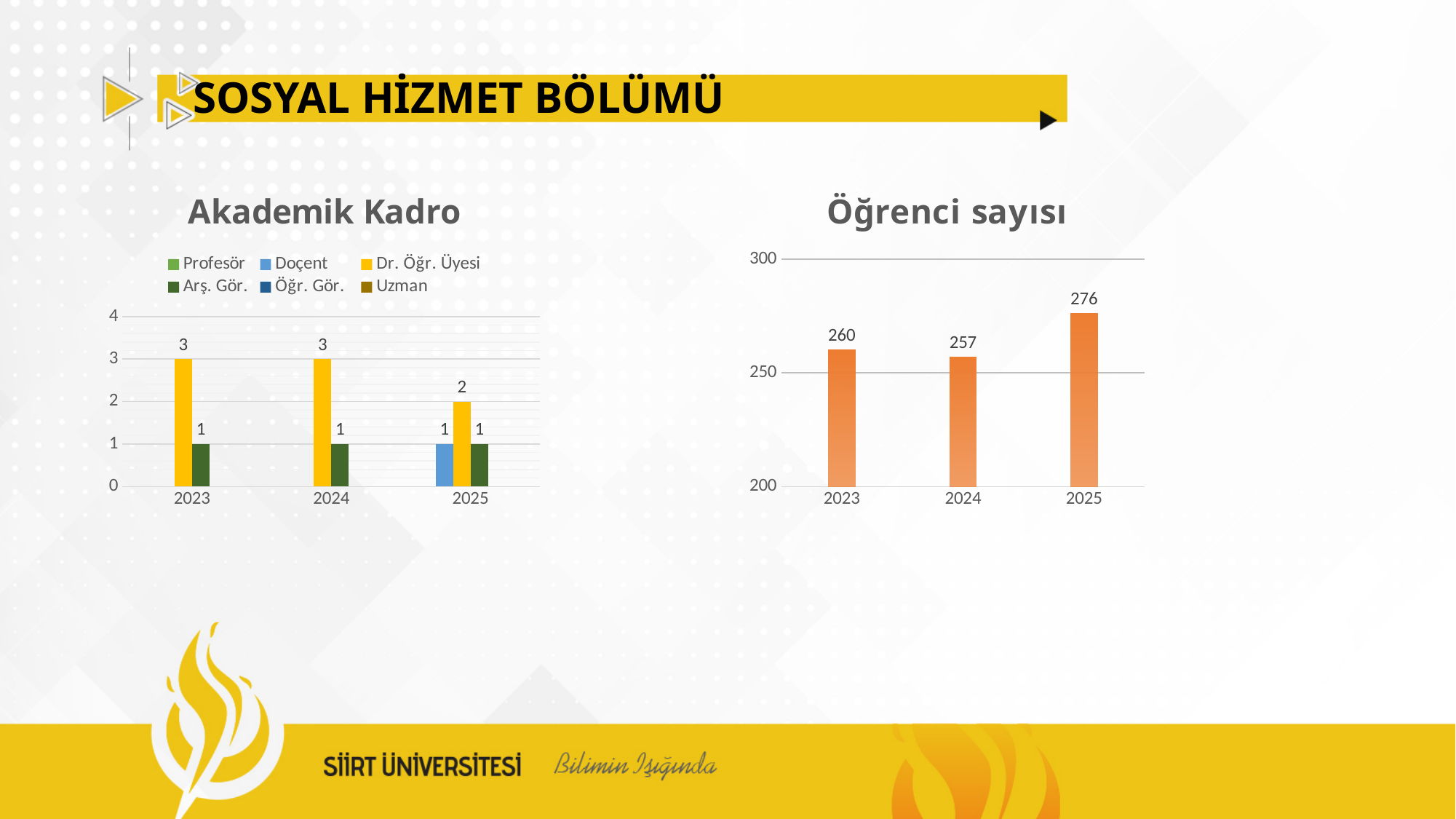
In the 'Öğrenci sayısı' chart, which year has the highest value? 2025 In the 'Akademik Kadro' chart, what is the value for Dr. Öğr. Üyesi in 2023? 3 In the 'Akademik Kadro' chart, which is larger in 2024: Dr. Öğr. Üyesi or Arş. Gör.? Dr. Öğr. Üyesi In the 'Öğrenci sayısı' chart, which year has the lowest value? 2024 What kind of chart is the 'Öğrenci sayısı' chart? Bar chart In the 'Akademik Kadro' chart, what is the difference between the Dr. Öğr. Üyesi value in 2024 and in 2025? 1 In the 'Öğrenci sayısı' chart, what is the difference between the 2025 and 2023 values? 16 In the 'Öğrenci sayısı' chart, how many years are shown on the x axis? 3 In the 'Öğrenci sayısı' chart, what is the value for 2024? 257 In the 'Akademik Kadro' chart, what is the value for Doçent in 2025? 1 In the 'Akademik Kadro' chart, how many series does the legend list? 6 In the 'Akademik Kadro' chart, what is the value for Dr. Öğr. Üyesi in 2025? 2